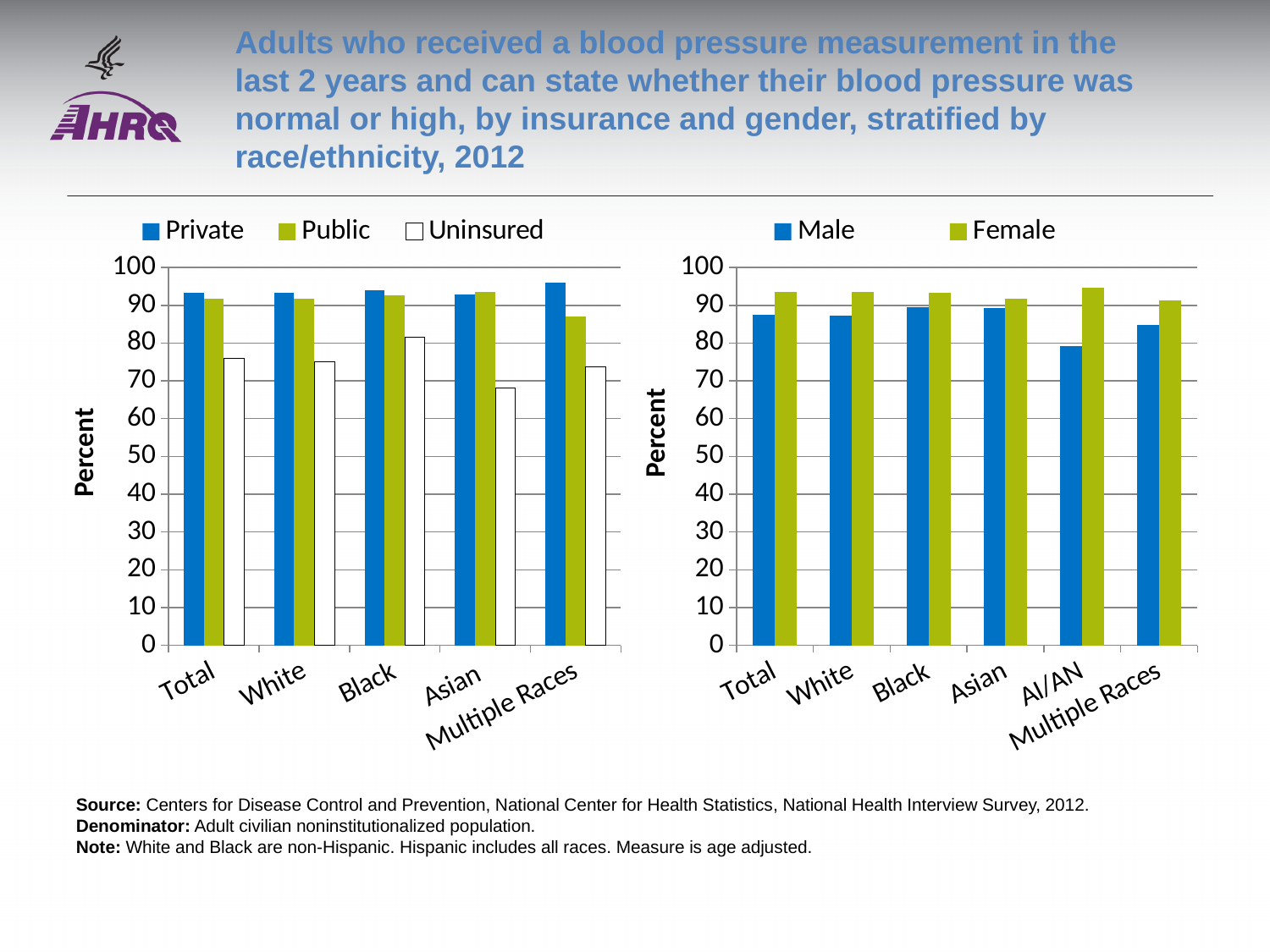
In the left chart, is the Uninsured value for Total greater or less than 80? less In the right chart, for AI/AN, which is larger: the Male value or the Female value? Female How many race/ethnicity categories are shown on the x axis of the left chart? 5 In the right chart, which category has the lowest Male value? AI/AN In the left chart, which category has the lowest Uninsured value? Asian In the left chart, which category has the highest Uninsured value? Black How many race/ethnicity categories are shown on the x axis of the right chart? 6 How many series does the legend of the left chart list? 3 In the right chart, is the Male value for AI/AN greater or less than 70? greater How many series does the legend of the right chart list? 2 What kind of chart is the left chart (Private/Public/Uninsured)? bar chart In the left chart, which category has the lowest Public value? Multiple Races